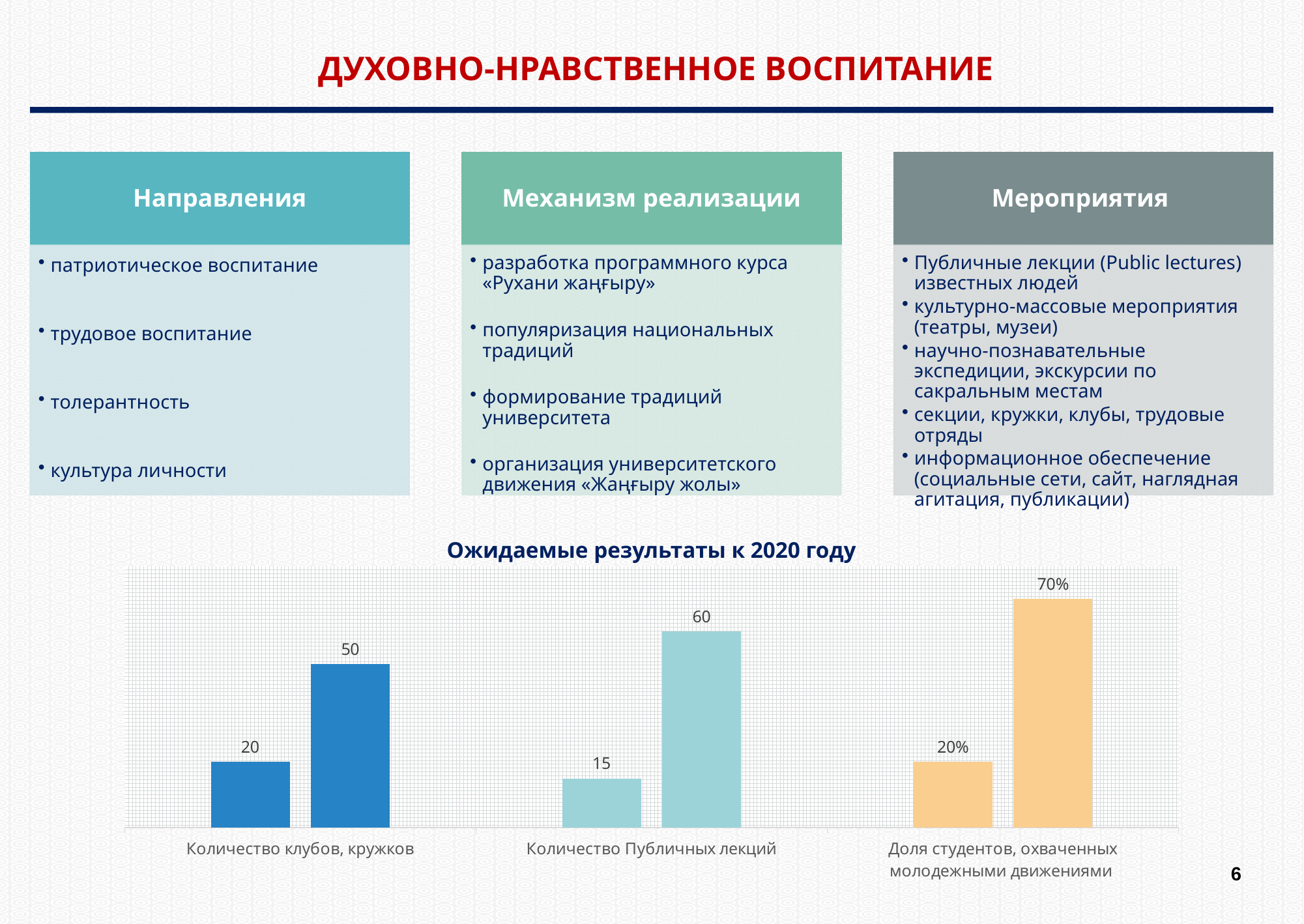
What is the value of the first (left) bar for "Количество Публичных лекций"? 15 What is the value of the second (right) bar for "Доля студентов, охваченных молодежными движениями"? 70% How many categories are shown on the x axis of the chart? 3 What kind of chart is shown under the heading "Ожидаемые результаты к 2020 году"? bar chart What is the title of the chart on the slide? Ожидаемые результаты к 2020 году What is the value of the first (left) bar for "Доля студентов, охваченных молодежными движениями"? 20% What is the difference between the two bars for "Количество Публичных лекций"? 45 What is the value of the second (right) bar for "Количество клубов, кружков"? 50 What is the value of the first (left) bar for "Количество клубов, кружков"? 20 Which category has the lowest-valued bar in the chart? Количество Публичных лекций Which is larger: the first bar for "Количество клубов, кружков" or the first bar for "Количество Публичных лекций"? Количество клубов, кружков What is the value of the second (right) bar for "Количество Публичных лекций"? 60